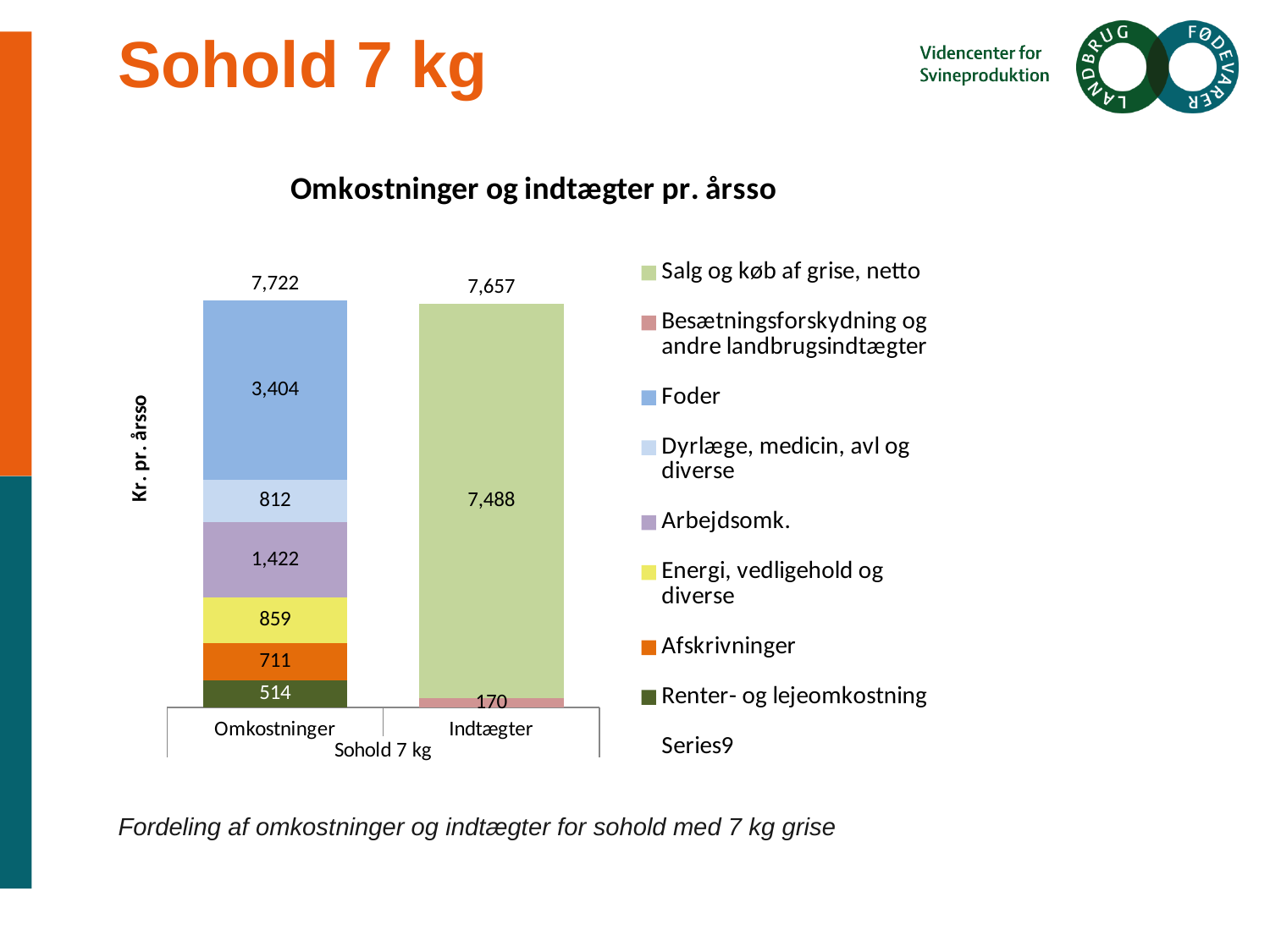
What is the value of the Arbejdsomk. segment in the Omkostninger bar? 1,422 What is the title of the chart? Omkostninger og indtægter pr. årsso What is the total shown above the Omkostninger bar? 7,722 Which is larger, the Afskrivninger segment or the Energi, vedligehold og diverse segment in the Omkostninger bar? Energi, vedligehold og diverse What is the difference between the Omkostninger total and the Indtægter total? 65 What is the value of the Salg og køb af grise, netto segment in the Indtægter bar? 7,488 What is the value of the Foder segment in the Omkostninger bar? 3,404 What is the value of the Besætningsforskydning og andre landbrugsindtægter segment in the Indtægter bar? 170 What kind of chart is shown on the slide? Stacked bar chart Which segment of the Omkostninger bar is the smallest? Renter- og lejeomkostning Which segment of the Omkostninger bar is the largest? Foder What is the total shown above the Indtægter bar? 7,657